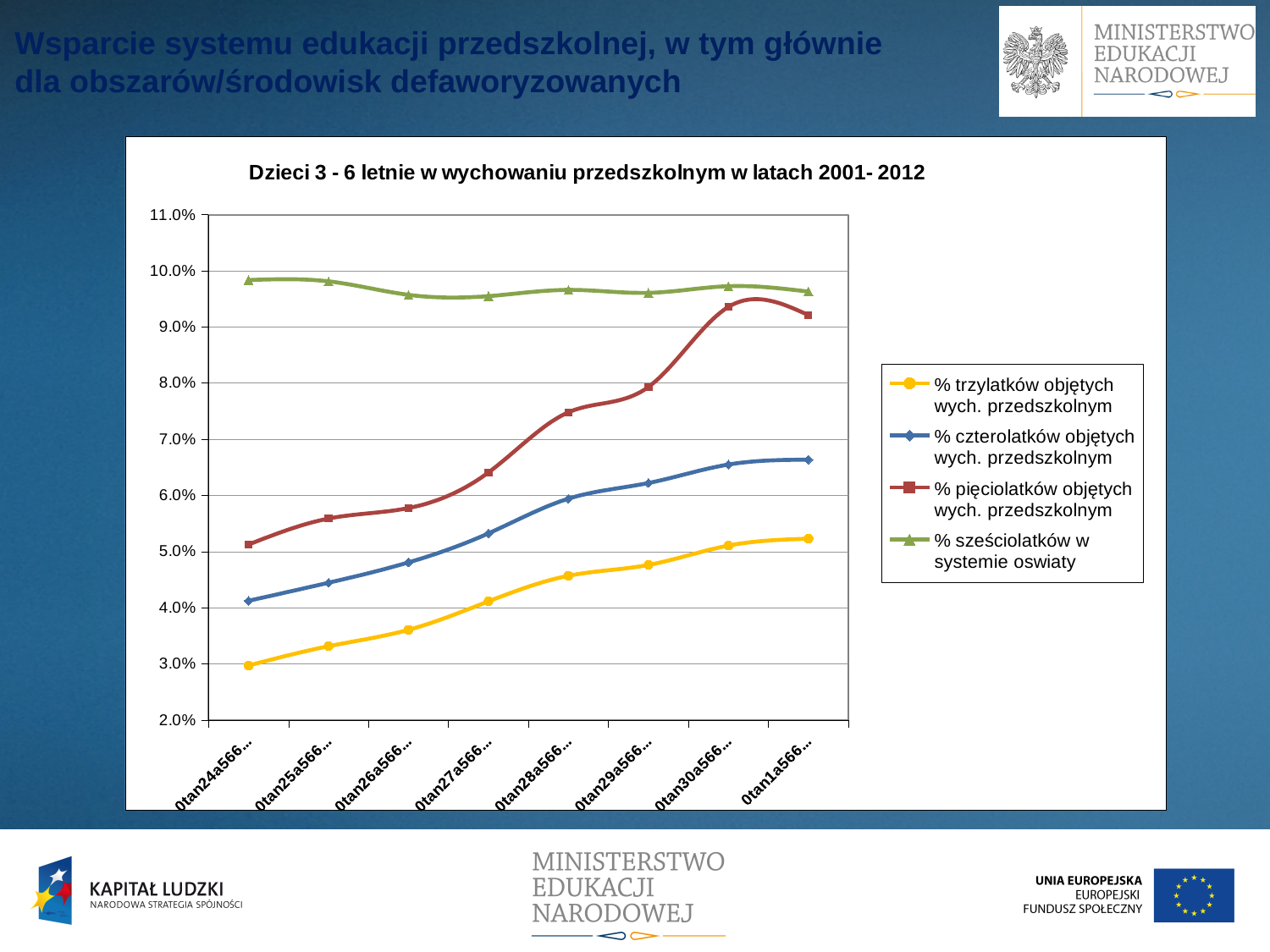
What kind of chart is shown on the slide? line chart At the first point on the x axis, which is larger: the value for % pięciolatków objętych wych. przedszkolnym or the value for % czterolatków objętych wych. przedszkolnym? % pięciolatków objętych wych. przedszkolnym How many series does the legend list? 4 Which series is plotted with the green line with triangle markers? % sześciolatków w systemie oswiaty Which series has the lowest values across the whole chart? % trzylatków objętych wych. przedszkolnym Does the line for % trzylatków objętych wych. przedszkolnym rise or fall from left to right? rise How many data points does each line have? 8 Is the highest point of the % pięciolatków objętych wych. przedszkolnym line greater or less than 9.0%? greater Is the last point of the % czterolatków objętych wych. przedszkolnym line greater or less than 6.0%? greater Which series has the highest values across the whole chart? % sześciolatków w systemie oswiaty What is the title of the chart? Dzieci 3 - 6 letnie w wychowaniu przedszkolnym w latach 2001- 2012 Is the first point of the % sześciolatków w systemie oswiaty line greater or less than 10.0%? less